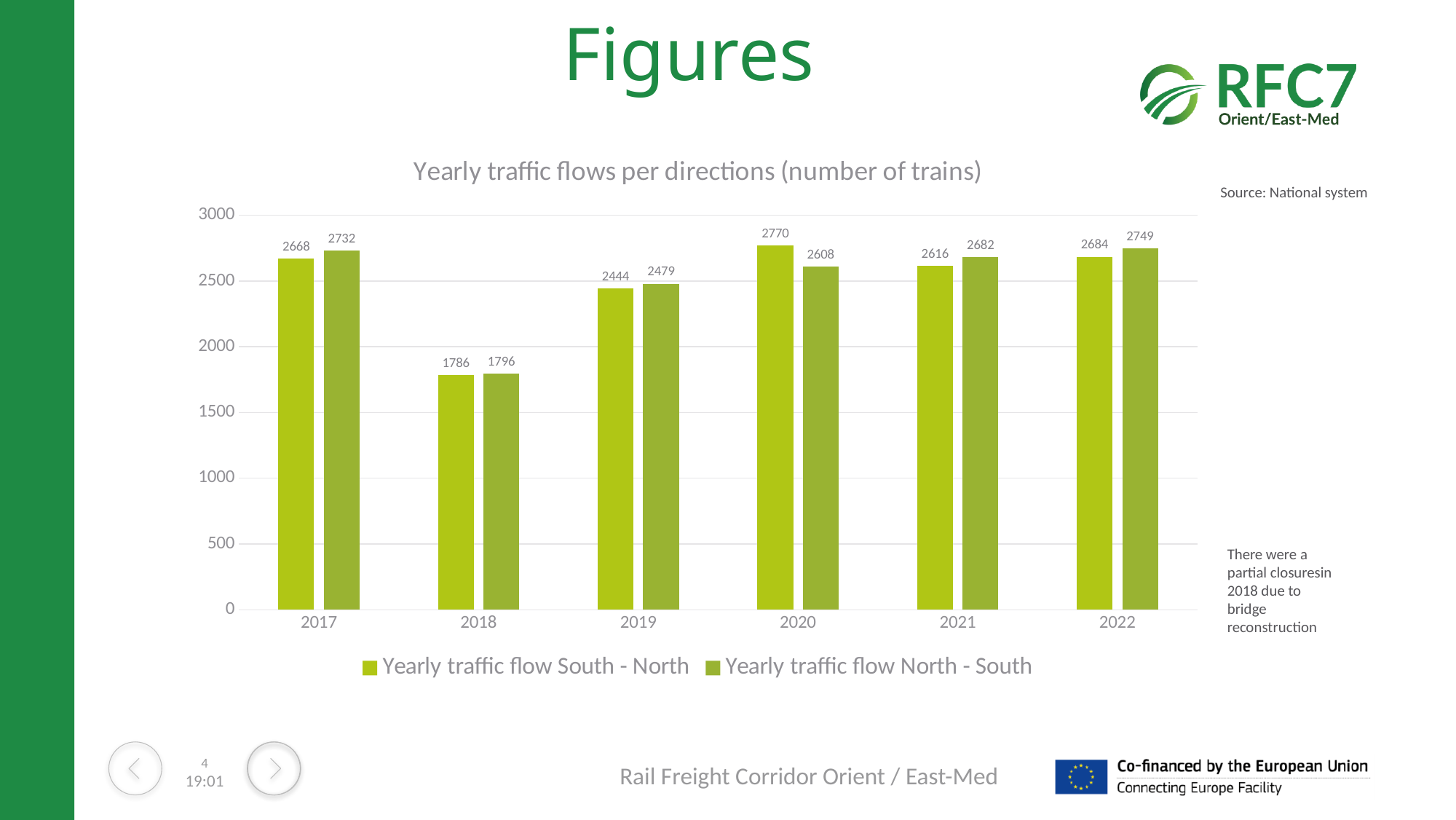
In 2020, which is larger: Yearly traffic flow South - North or Yearly traffic flow North - South? Yearly traffic flow South - North What is the value of Yearly traffic flow North - South in 2018? 1796 What is the title of the chart? Yearly traffic flows per directions (number of trains) Is the value for Yearly traffic flow South - North in 2019 greater or less than 2500? less What is the difference between the North - South and South - North values in 2021? 66 What is the value of Yearly traffic flow South - North in 2020? 2770 Which year has the highest value for Yearly traffic flow South - North? 2020 What is the value of Yearly traffic flow North - South in 2022? 2749 How many years are shown on the x axis? 6 How many series does the legend list? 2 What kind of chart is shown on the slide? bar chart Which year has the lowest value for Yearly traffic flow South - North? 2018